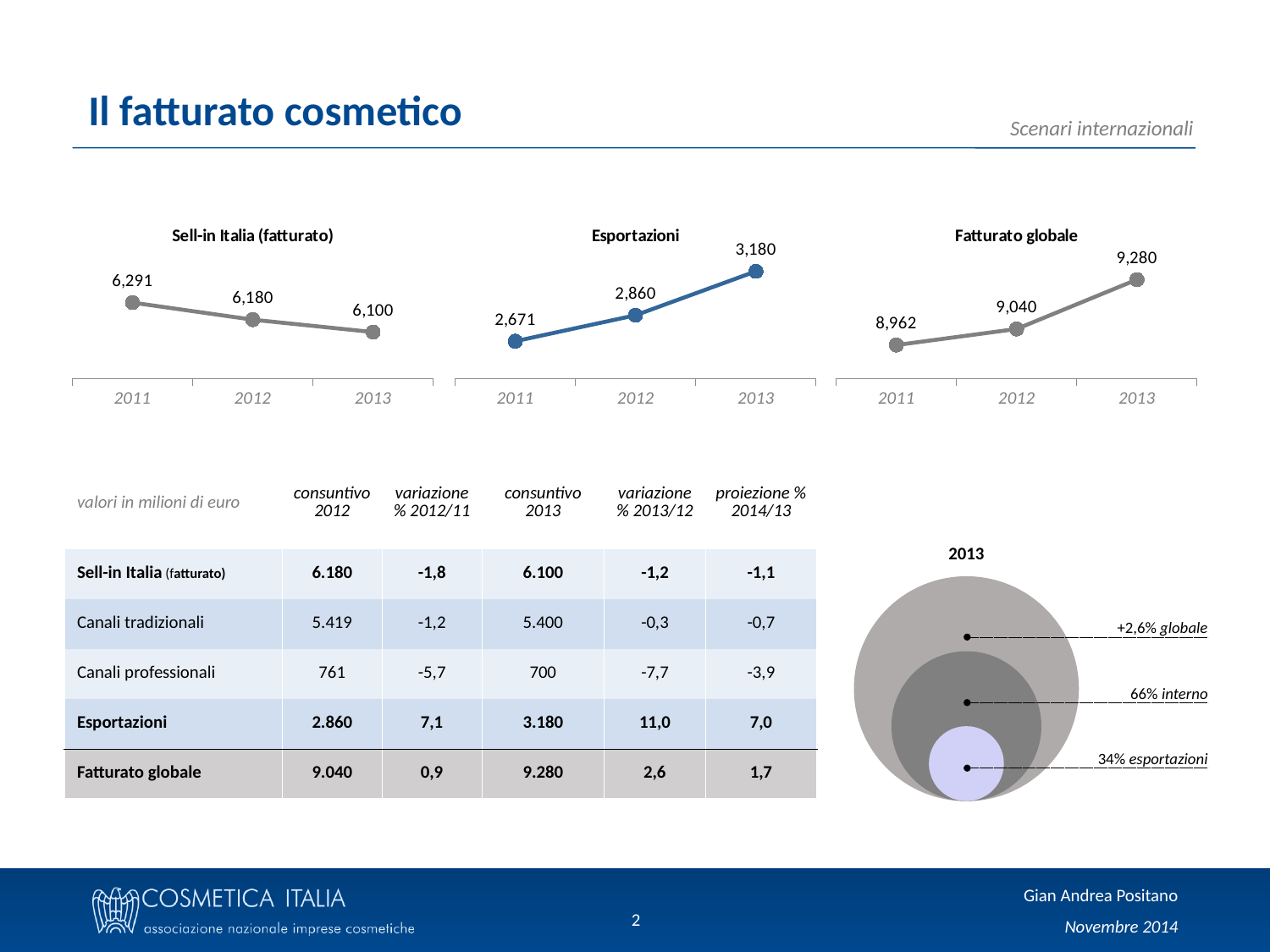
In the 'Sell-in Italia (fatturato)' chart, do the values rise or fall from 2011 to 2013? fall In the 'Sell-in Italia (fatturato)' chart, which year has the lowest value? 2013 In the 'Fatturato globale' chart, do the values rise or fall from 2011 to 2013? rise In the 'Sell-in Italia (fatturato)' chart, is the value for 2012 larger or smaller than the value for 2013? larger In the 'Fatturato globale' chart, what is the difference between the 2013 and 2011 values? 318 In the 'Esportazioni' chart, what is the difference between the 2013 and 2012 values? 320 In the 'Esportazioni' chart, which year has the highest value? 2013 How many data points are plotted in the 'Esportazioni' chart? 3 In the 'Sell-in Italia (fatturato)' chart, what is the value for 2011? 6,291 In the 'Esportazioni' chart, what is the value for 2013? 3,180 What type of chart is the 'Fatturato globale' chart? line chart In the 'Fatturato globale' chart, what is the value for 2012? 9,040